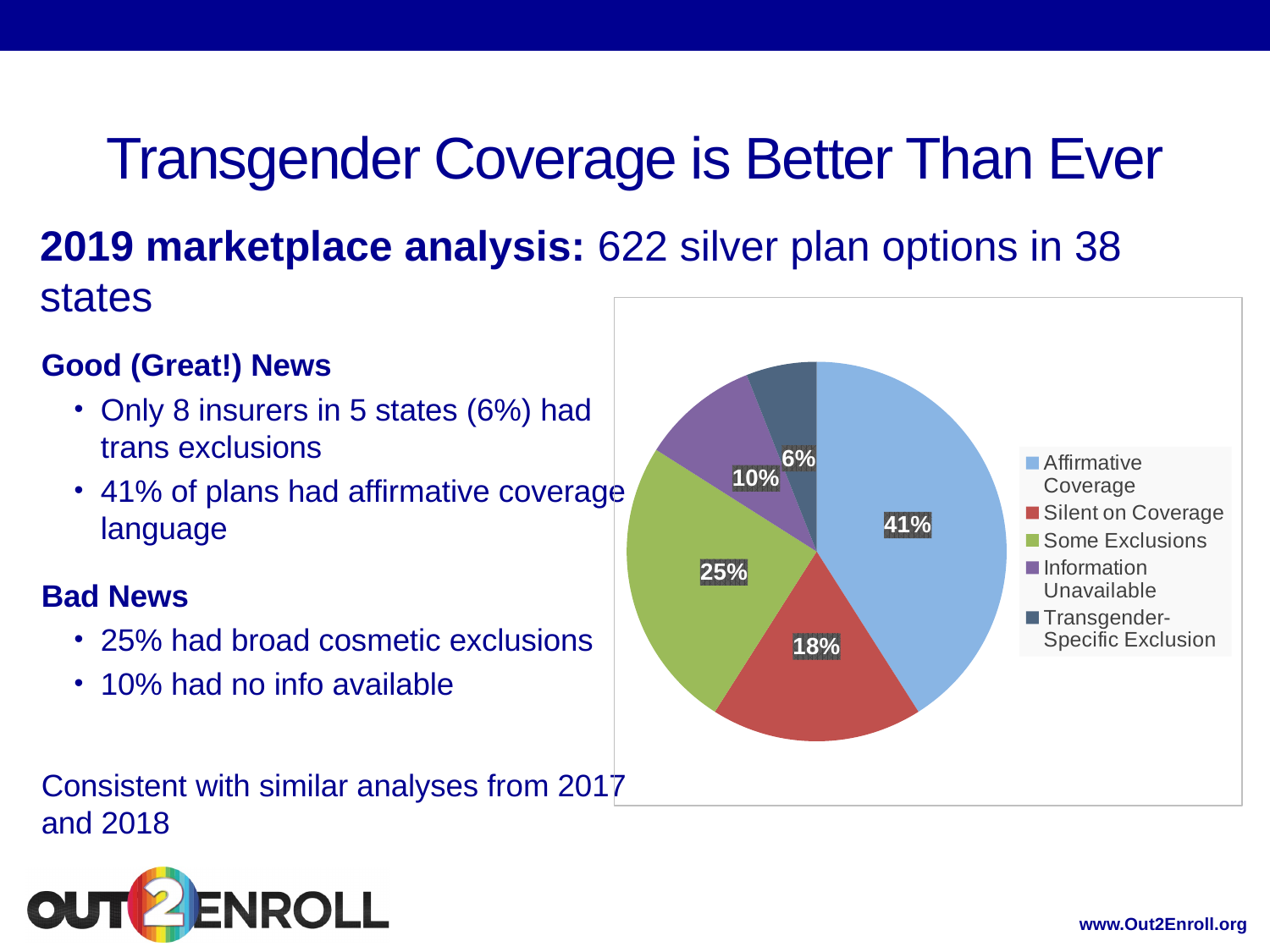
Which is larger, Silent on Coverage or Information Unavailable? Silent on Coverage What share of the pie is Some Exclusions? 25% How many categories does the pie chart show? 5 What share of the pie is Silent on Coverage? 18% What kind of chart is shown on the slide? pie chart What share of the pie is Information Unavailable? 10% What is the difference in percentage points between Affirmative Coverage and Some Exclusions? 16 Which category has the largest slice of the pie? Affirmative Coverage What colour is the Some Exclusions slice? green Which category has the smallest slice of the pie? Transgender-Specific Exclusion